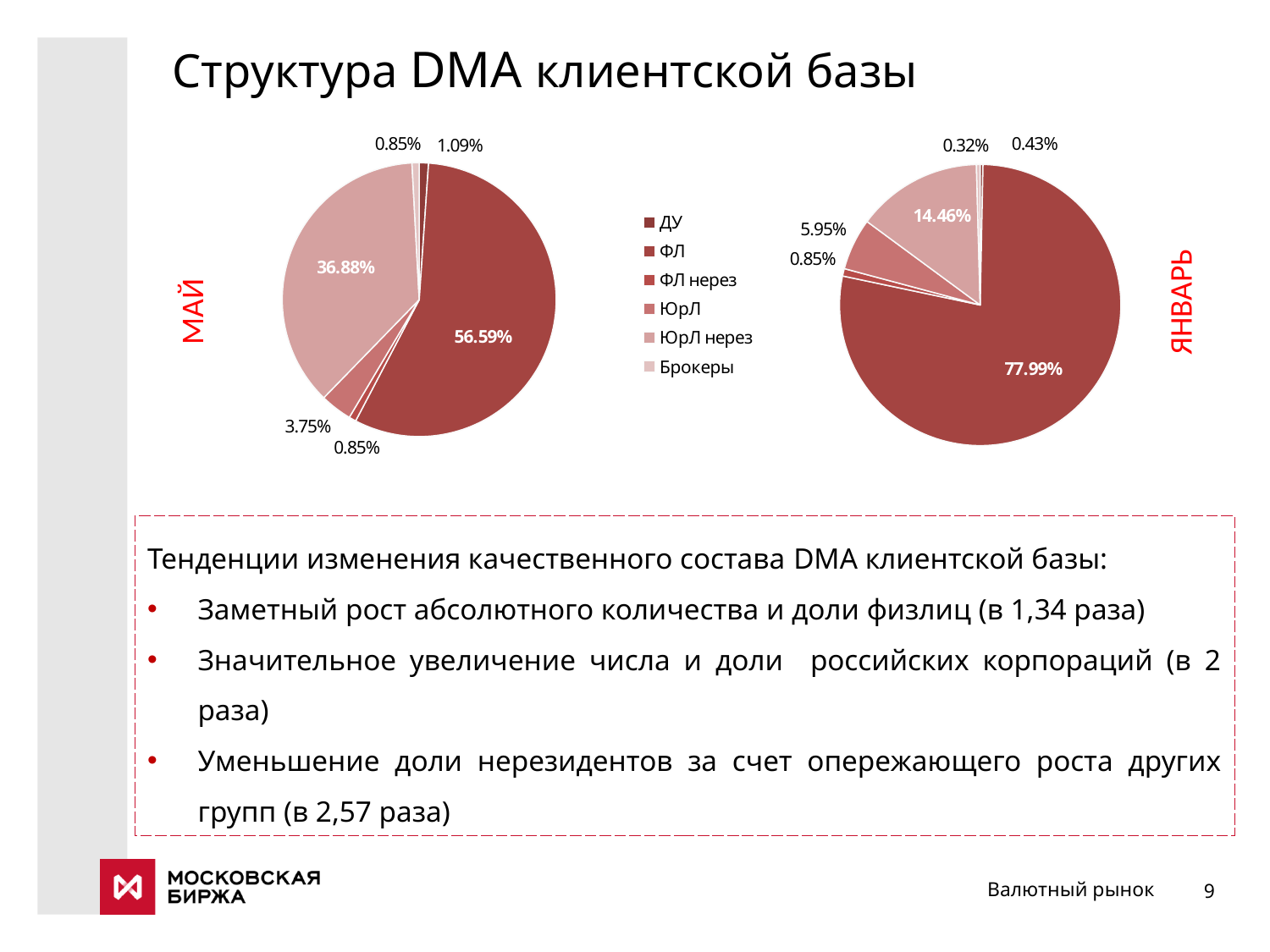
Which chart has the larger share for ФЛ, МАЙ or ЯНВАРЬ? ЯНВАРЬ In the МАЙ pie chart, what is the share of ЮрЛ? 3.75% In the ЯНВАРЬ pie chart, what is the share of the smallest slice? 0.32% How many entries does the legend list? 6 What is the difference between the ФЛ share in ЯНВАРЬ (77.99%) and in МАЙ (56.59%)? 21.40% In the ЯНВАРЬ pie chart, what is the share of the largest slice? 77.99% In the МАЙ pie chart, what is the share of ЮрЛ нерез? 36.88% In the ЯНВАРЬ pie chart, what is the share of ЮрЛ нерез? 14.46% What is the title of the slide containing the pie charts? Структура DMA клиентской базы What kind of charts are shown on the slide? Pie charts In the МАЙ pie chart, what is the share of the largest slice? 56.59% In the ЯНВАРЬ pie chart, what is the share of ЮрЛ? 5.95%